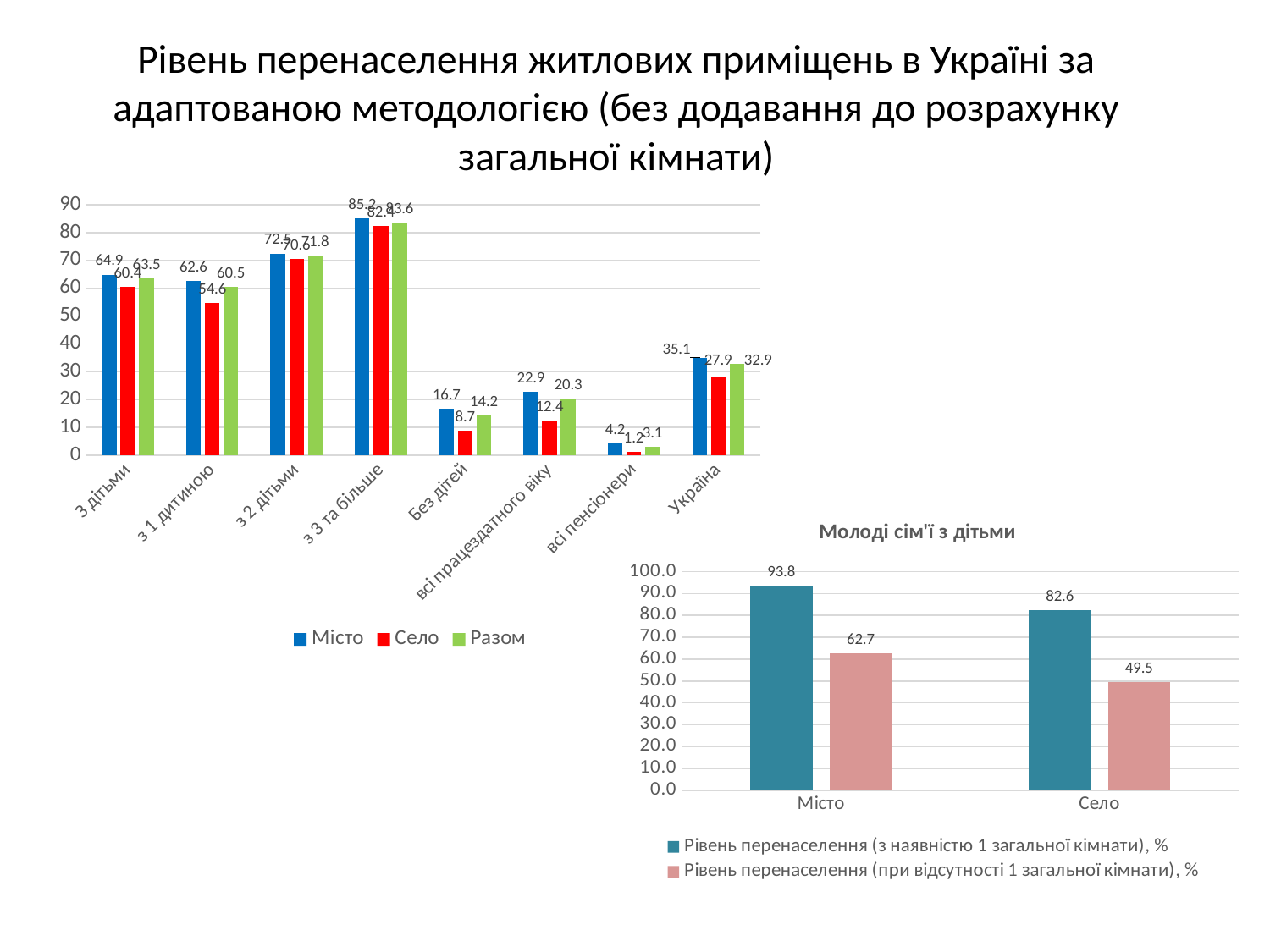
In the chart titled 'Молоді сім'ї з дітьми', what is the value for Місто in the series 'Рівень перенаселення (з наявністю 1 загальної кімнати), %'? 93.8 What type of chart is the chart titled 'Молоді сім'ї з дітьми'? Bar chart In the chart titled 'Молоді сім'ї з дітьми', how many series does the legend list? 2 In the large chart at the top left, what is the value for Село in the category 'Україна'? 27.9 In the chart titled 'Молоді сім'ї з дітьми', what is the difference between the two values for Місто? 31.1 In the large chart at the top left, how many categories are shown on the x axis? 8 In the large chart at the top left, which is larger for the category 'з 1 дитиною': Місто or Село? Місто In the large chart at the top left, what is the value for Місто in the category 'Без дітей'? 16.7 In the chart titled 'Молоді сім'ї з дітьми', what is the value for Село in the series 'Рівень перенаселення (при відсутності 1 загальної кімнати), %'? 49.5 In the large chart at the top left, what is the value for Разом in the category 'з 2 дітьми'? 71.8 In the large chart at the top left, which category has the lowest value for Село? всі пенсіонери In the large chart at the top left, which category has the highest value for Місто? з 3 та більше